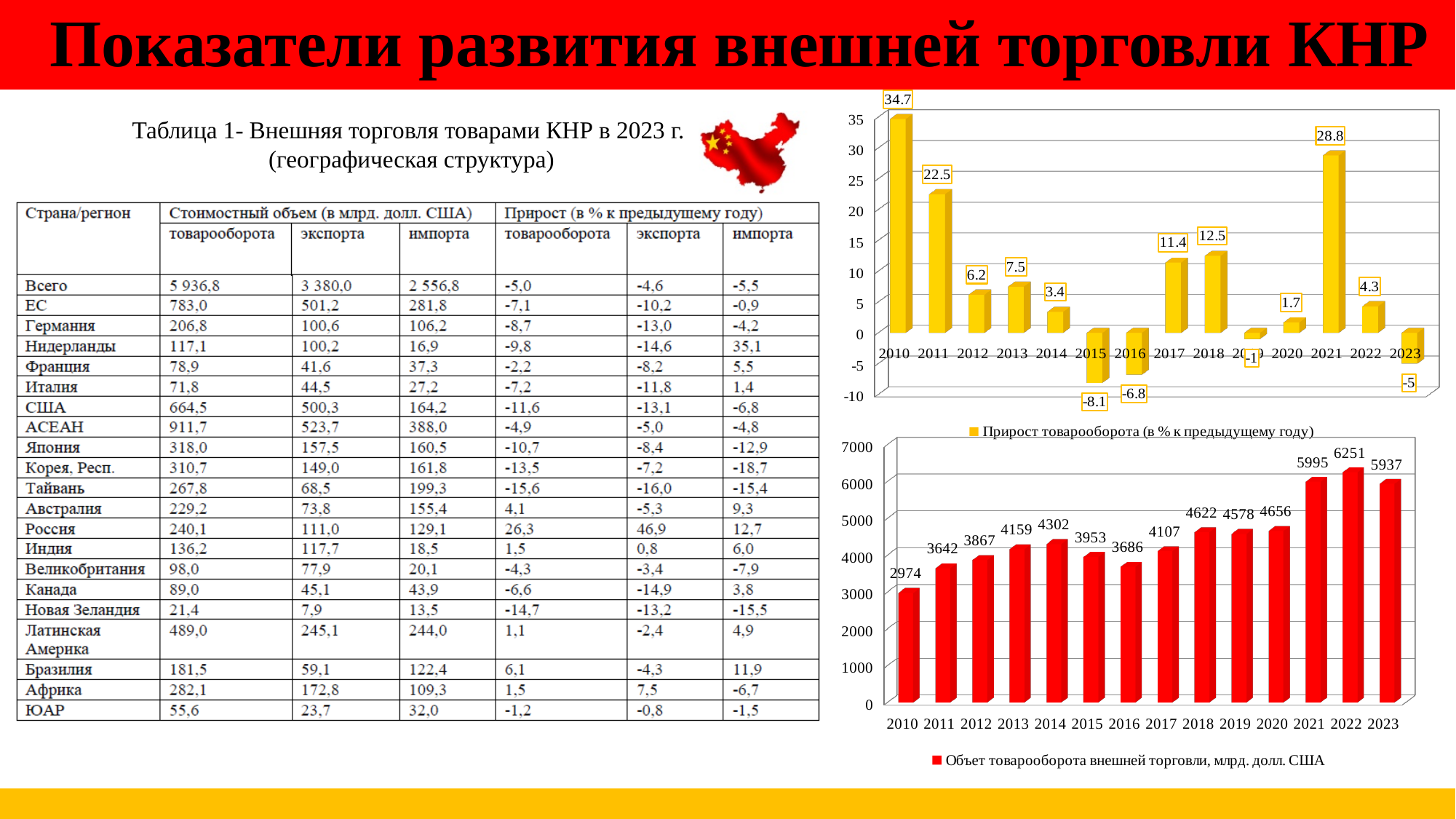
In the bottom chart (Объем товарооборота внешней торговли), what is the value for 2022? 6251 In the top chart (Прирост товарооборота), how many years are plotted? 14 What kind of chart is the bottom chart (Объем товарооборота внешней торговли)? bar chart In the top chart (Прирост товарооборота), what is the difference between the values for 2018 and 2017? 1.1 In the bottom chart (Объем товарооборота внешней торговли), what colour are the bars? red In the top chart (Прирост товарооборота), which year has the lowest value? 2015 In the bottom chart (Объем товарооборота внешней торговли), what is the difference between the values for 2021 and 2020? 1339 In the bottom chart (Объем товарооборота внешней торговли), which is larger, the value for 2015 or the value for 2016? 2015 In the top chart (Прирост товарооборота), what is the value for 2021? 28.8 In the bottom chart (Объем товарооборота внешней торговли), is the value for 2013 greater or less than 4000? greater In the bottom chart (Объем товарооборота внешней торговли), which year has the lowest value? 2010 In the top chart (Прирост товарооборота), which year has the highest value? 2010